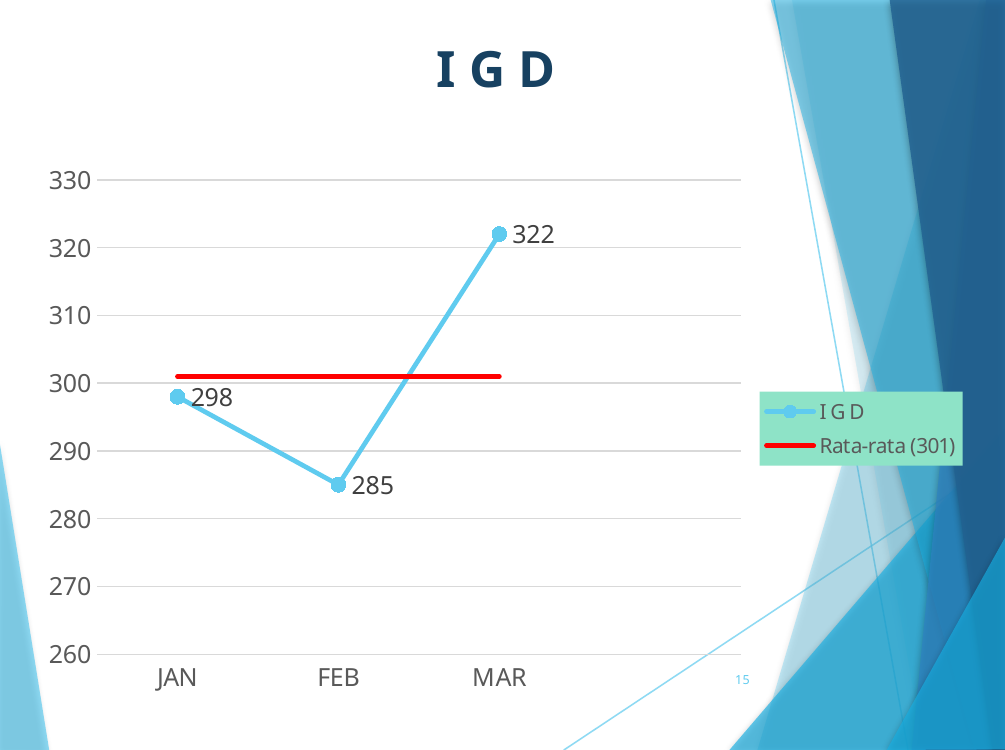
What is the I G D value for FEB? 285 What is the I G D value for JAN? 298 What value does the Rata-rata line represent according to the legend? 301 Which month has the highest I G D value? MAR Which month has the lowest I G D value? FEB How many months are plotted on the x axis? 3 What kind of chart is shown on the slide? line chart What is the I G D value for MAR? 322 How many series does the legend list? 2 What is the difference between the I G D values for MAR and FEB? 37 Which is larger, the I G D value for JAN or for FEB? JAN Is the I G D value for MAR greater or less than 310? greater